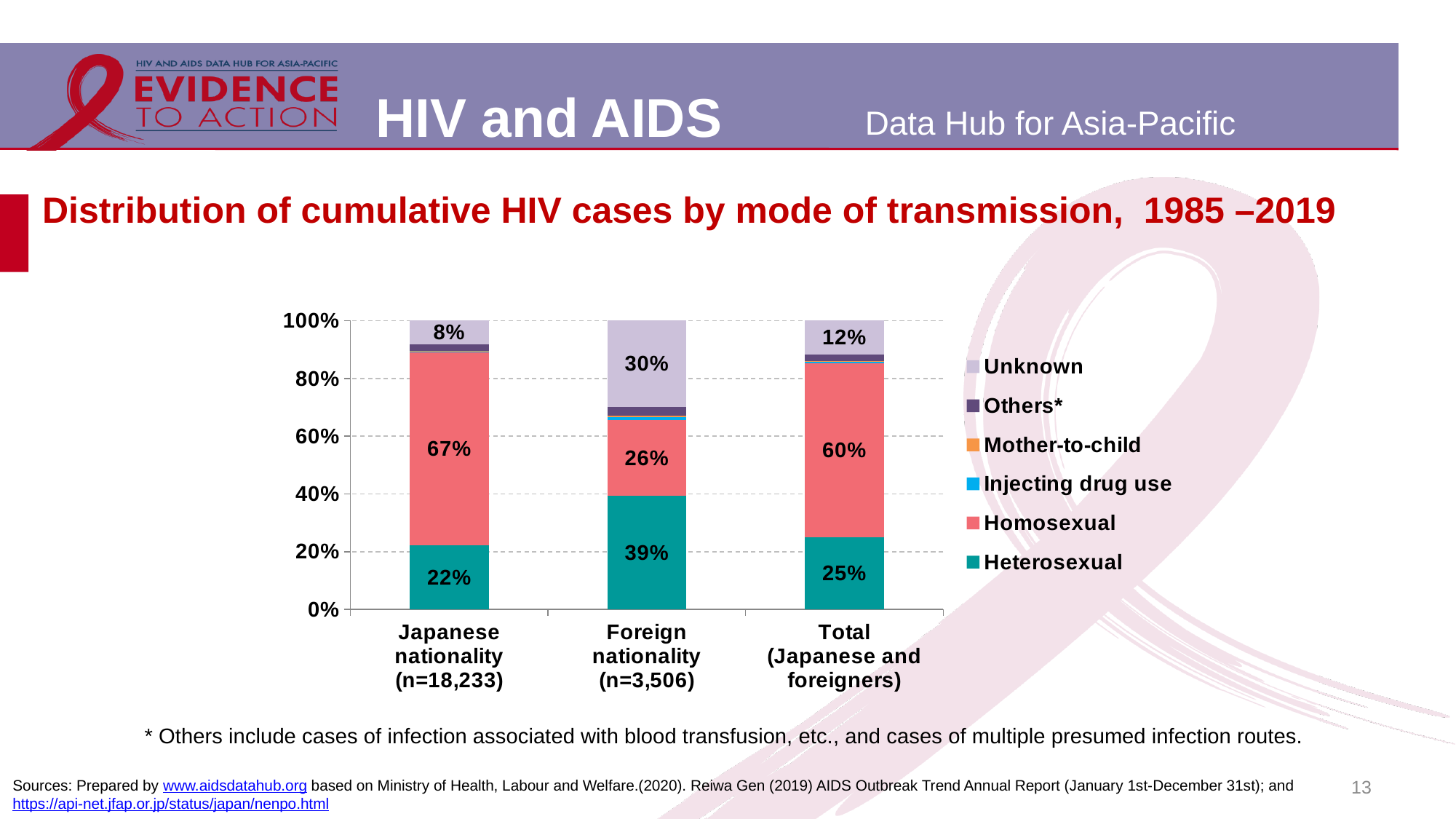
Is the heterosexual share larger for Japanese nationality or for Foreign nationality? Foreign nationality What type of chart is used on this slide? Stacked bar chart Which legend entry is marked with an asterisk? Others* Which nationality group has the highest homosexual transmission share? Japanese nationality (n=18,233) What is the Unknown share for Foreign nationality? 30% What is the difference between the homosexual share for Japanese nationality and for Foreign nationality? 41 percentage points How many nationality groups (bars) are shown in the chart? 3 What percentage of the Total (Japanese and foreigners) bar is labelled Unknown? 12% Which nationality group has the lowest Unknown share? Japanese nationality (n=18,233) How many modes of transmission does the legend list? 6 What is the heterosexual share for the Foreign nationality (n=3,506) bar? 39% What percentage of cumulative HIV cases among Japanese nationality is attributed to homosexual transmission? 67%